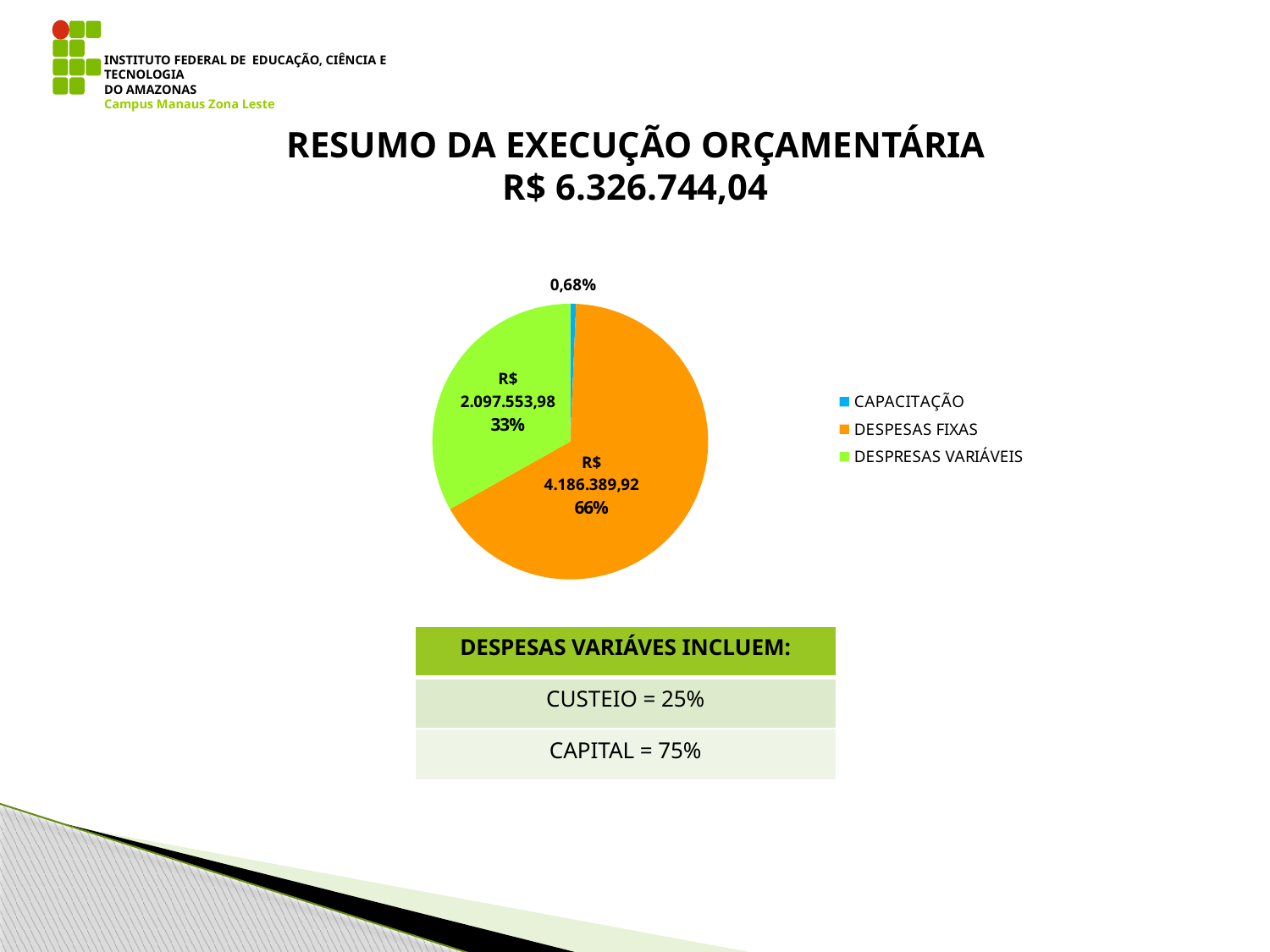
What percentage share of the pie does CAPACITAÇÃO represent? 0,68% Which category has the largest slice in the pie chart? DESPESAS FIXAS Which colour represents CAPACITAÇÃO in the pie chart? Blue What percentage share of the pie does DESPRESAS VARIÁVEIS represent? 33% Which category has the smallest slice in the pie chart? CAPACITAÇÃO What percentage share of the pie does DESPESAS FIXAS represent? 66% How many slices does the pie chart have? 3 How many entries does the legend of the pie chart list? 3 What is the value shown for DESPESAS FIXAS in the pie chart? R$ 4.186.389,92 What is the value shown for DESPRESAS VARIÁVEIS in the pie chart? R$ 2.097.553,98 What type of chart is shown on the slide? Pie chart What is the difference between the values for DESPESAS FIXAS and DESPRESAS VARIÁVEIS? R$ 2.088.835,94